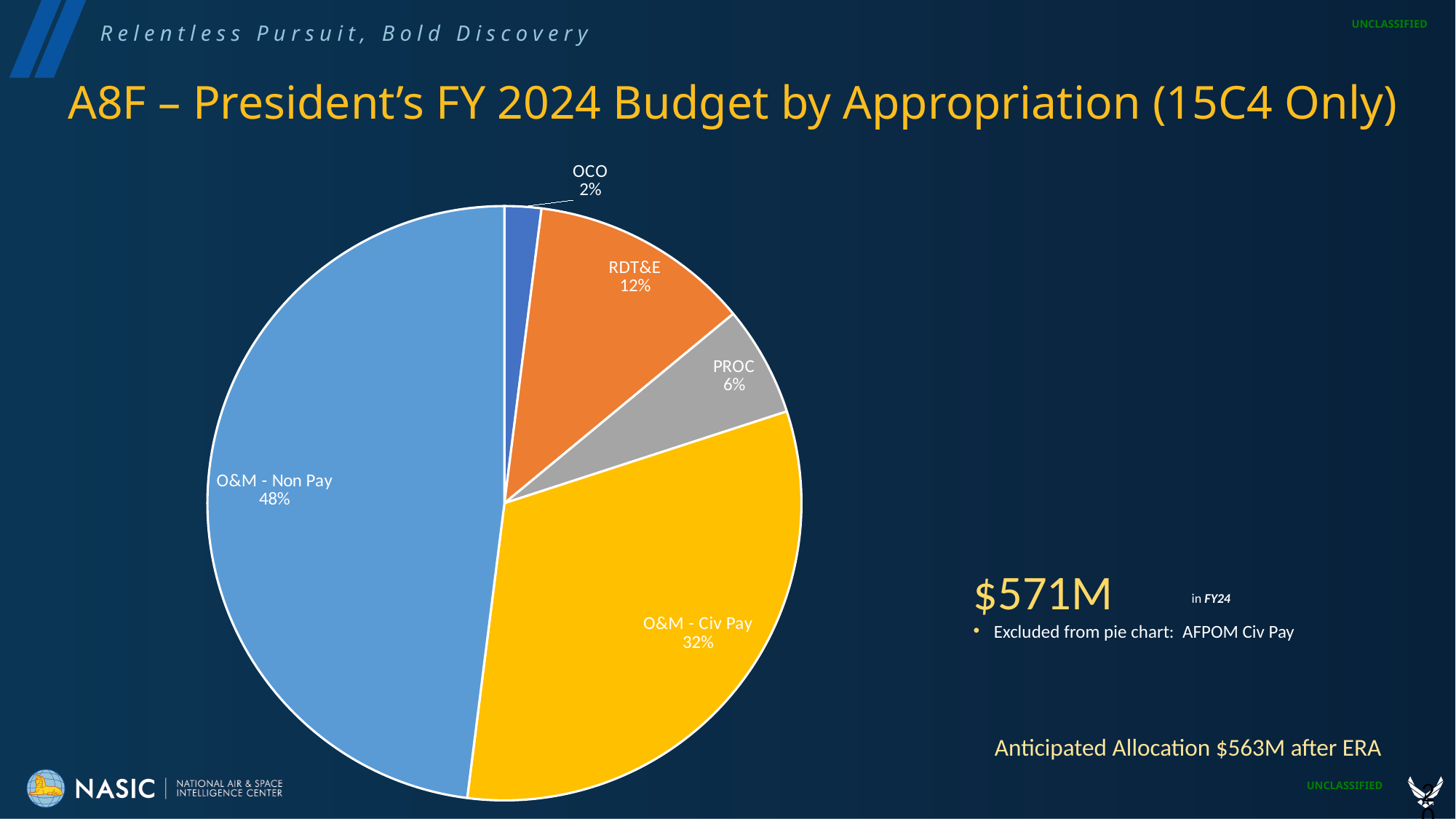
What colour is the O&M - Civ Pay slice? yellow Which slice of the pie is the smallest? OCO What is the difference in percentage points between O&M - Non Pay and O&M - Civ Pay? 16% What is the value shown for OCO? 2% How many slices does the pie chart have? 5 What kind of chart is shown on the slide? pie chart Which is larger, RDT&E or PROC? RDT&E Which slice of the pie is the largest? O&M - Non Pay What share of the pie does O&M - Civ Pay represent? 32% What is the value shown for PROC? 6% What share of the pie does O&M - Non Pay represent? 48% What is the value shown for RDT&E? 12%